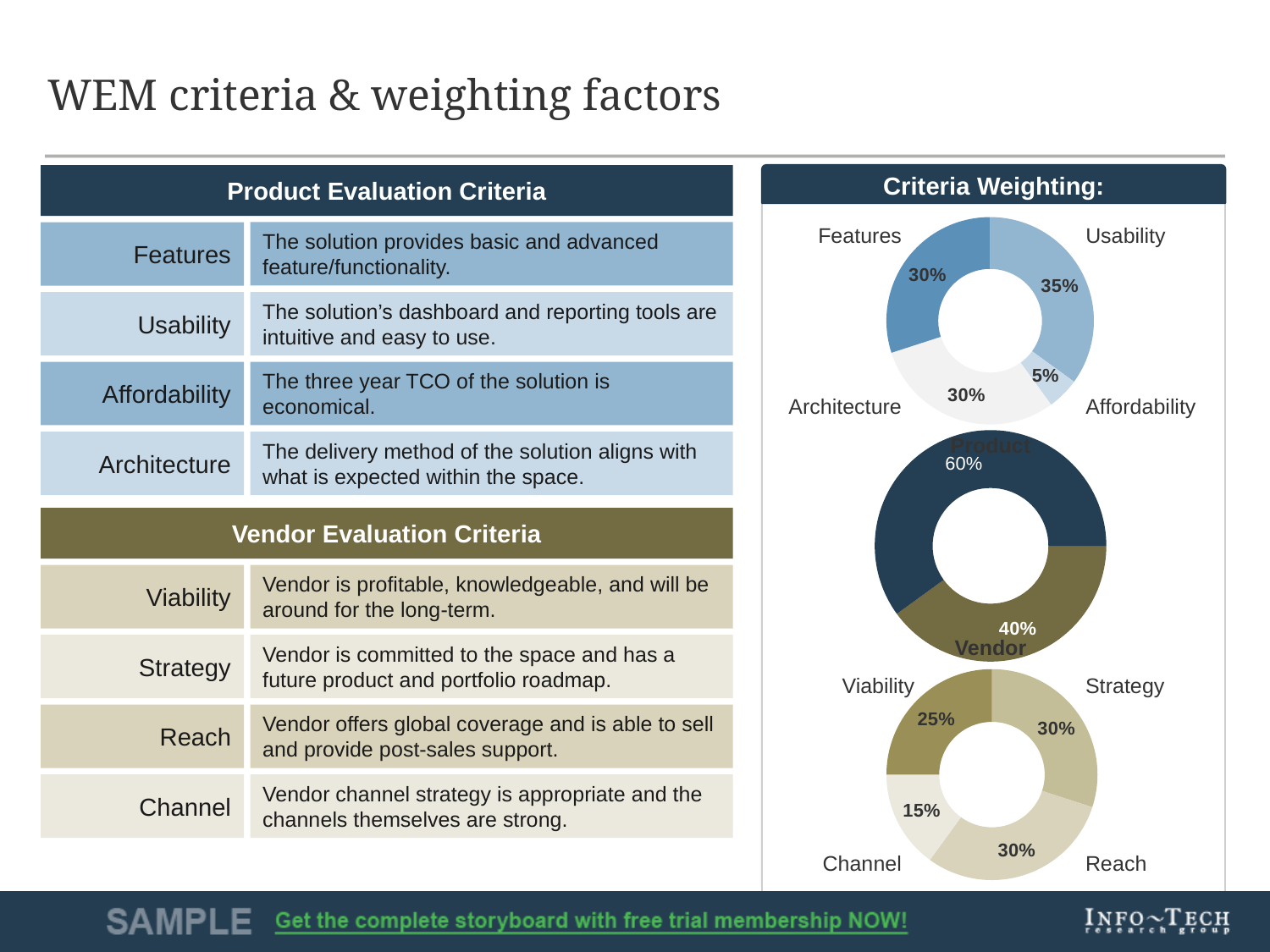
In the top donut chart (product criteria), which criterion has the lowest weighting? Affordability In the bottom donut chart (vendor criteria), which criterion has the lowest weighting? Channel In the middle donut chart, which is weighted more, Product or Vendor? Product In the top donut chart (product criteria), what is the difference between the Usability and Affordability weightings? 30% In the top donut chart (product criteria), which criterion has the highest weighting? Usability In the bottom donut chart (vendor criteria), what is the difference between the Viability and Channel weightings? 10% In the bottom donut chart (vendor criteria), what is the weighting for Viability? 25% In the top donut chart (product criteria), what is the weighting for Affordability? 5% How many categories are shown in the bottom donut chart (vendor criteria)? 4 In the top donut chart (product criteria), what is the weighting for Usability? 35% In the middle donut chart, what is the weighting for Product? 60% What type of chart is used to show the criteria weightings on the right side of the slide? Donut (pie) chart